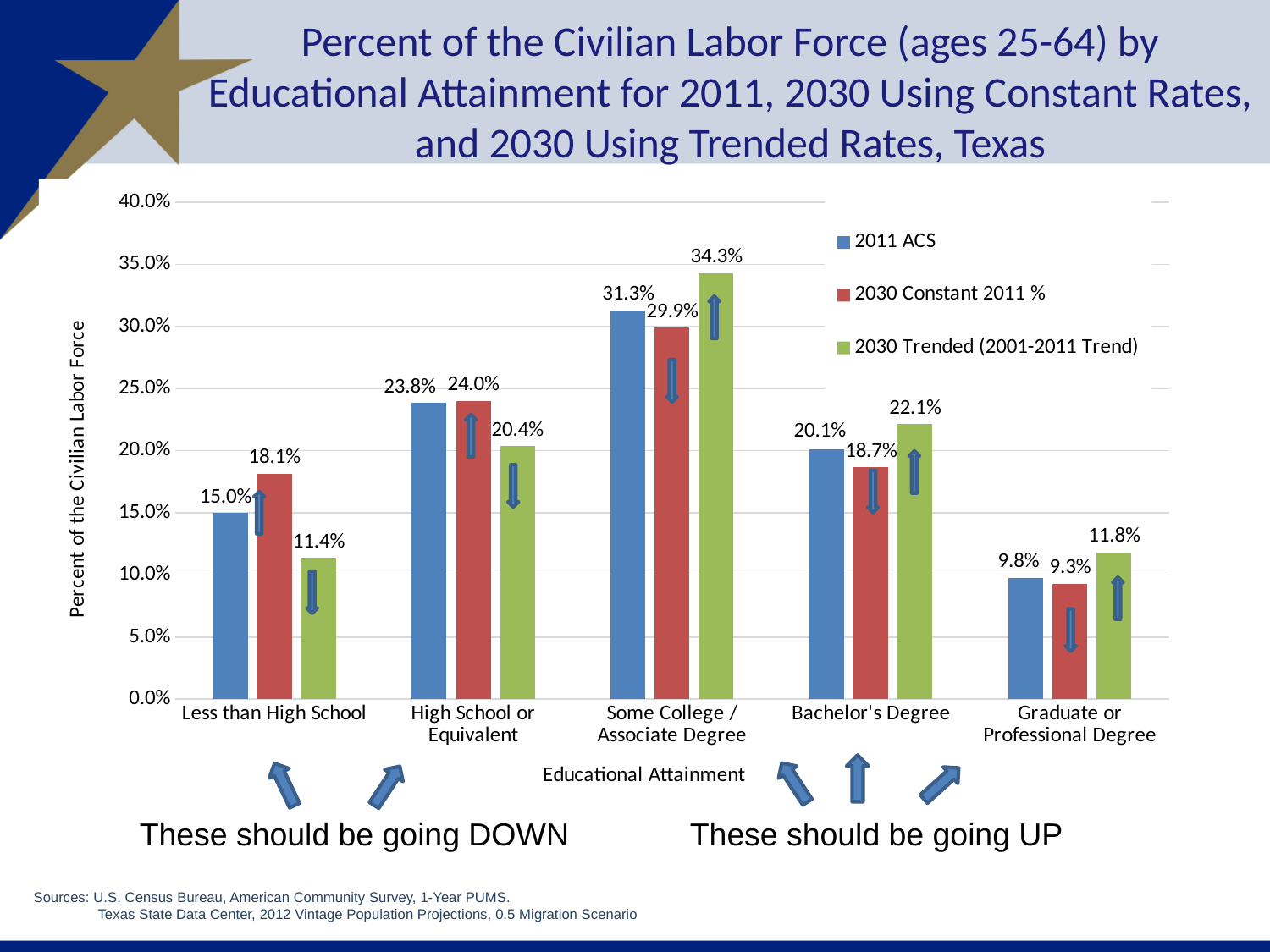
What is the label of the y axis? Percent of the Civilian Labor Force Which educational attainment category has the highest 2030 Trended (2001-2011 Trend) value? Some College / Associate Degree What is the 2030 Constant 2011 % value for Bachelor's Degree? 18.7% Which is larger for High School or Equivalent: the 2011 ACS value or the 2030 Trended (2001-2011 Trend) value? 2011 ACS Which educational attainment category has the lowest 2011 ACS value? Graduate or Professional Degree What kind of chart is shown on the slide? Bar chart What is the difference between the 2030 Trended and 2011 ACS values for Bachelor's Degree? 2.0% How many educational attainment categories are shown on the x axis? 5 What is the difference between the 2030 Constant 2011 % and 2030 Trended values for Graduate or Professional Degree? 2.5% What is the 2030 Trended (2001-2011 Trend) value for Less than High School? 11.4% How many series does the legend list? 3 What is the 2011 ACS value for Some College / Associate Degree? 31.3%